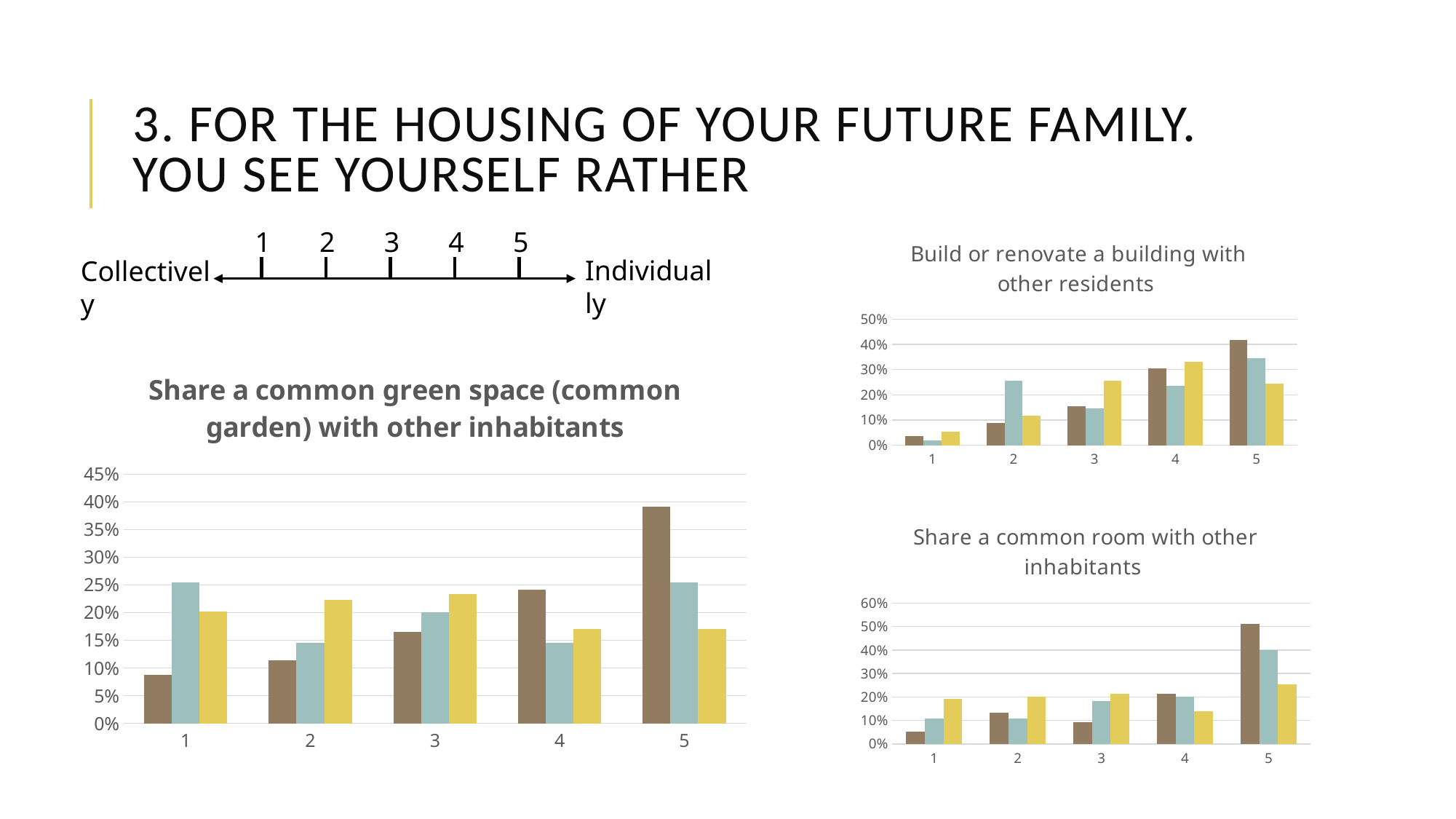
How many categories are shown on the x axis of the "Share a common green space (common garden) with other inhabitants" chart? 5 In the "Share a common green space (common garden) with other inhabitants" chart, do the brown bars rise or fall from category 1 to category 5? rise In the "Share a common green space (common garden) with other inhabitants" chart, is the brown bar for category 5 greater or less than 35%? greater In the "Build or renovate a building with other residents" chart, is the brown bar for category 5 greater or less than 30%? greater In the "Share a common room with other inhabitants" chart, is the brown bar for category 1 greater or less than 10%? less In the "Build or renovate a building with other residents" chart, which category has the tallest bar overall? 5 In the "Share a common room with other inhabitants" chart, at category 5, which is larger: the brown bar or the teal bar? the brown bar In the "Share a common green space (common garden) with other inhabitants" chart, which category has the shortest brown bar? 1 What is the highest value shown on the y axis of the "Share a common room with other inhabitants" chart? 60% What kind of chart is "Share a common green space (common garden) with other inhabitants"? bar chart In the "Share a common green space (common garden) with other inhabitants" chart, which category has the tallest brown bar? 5